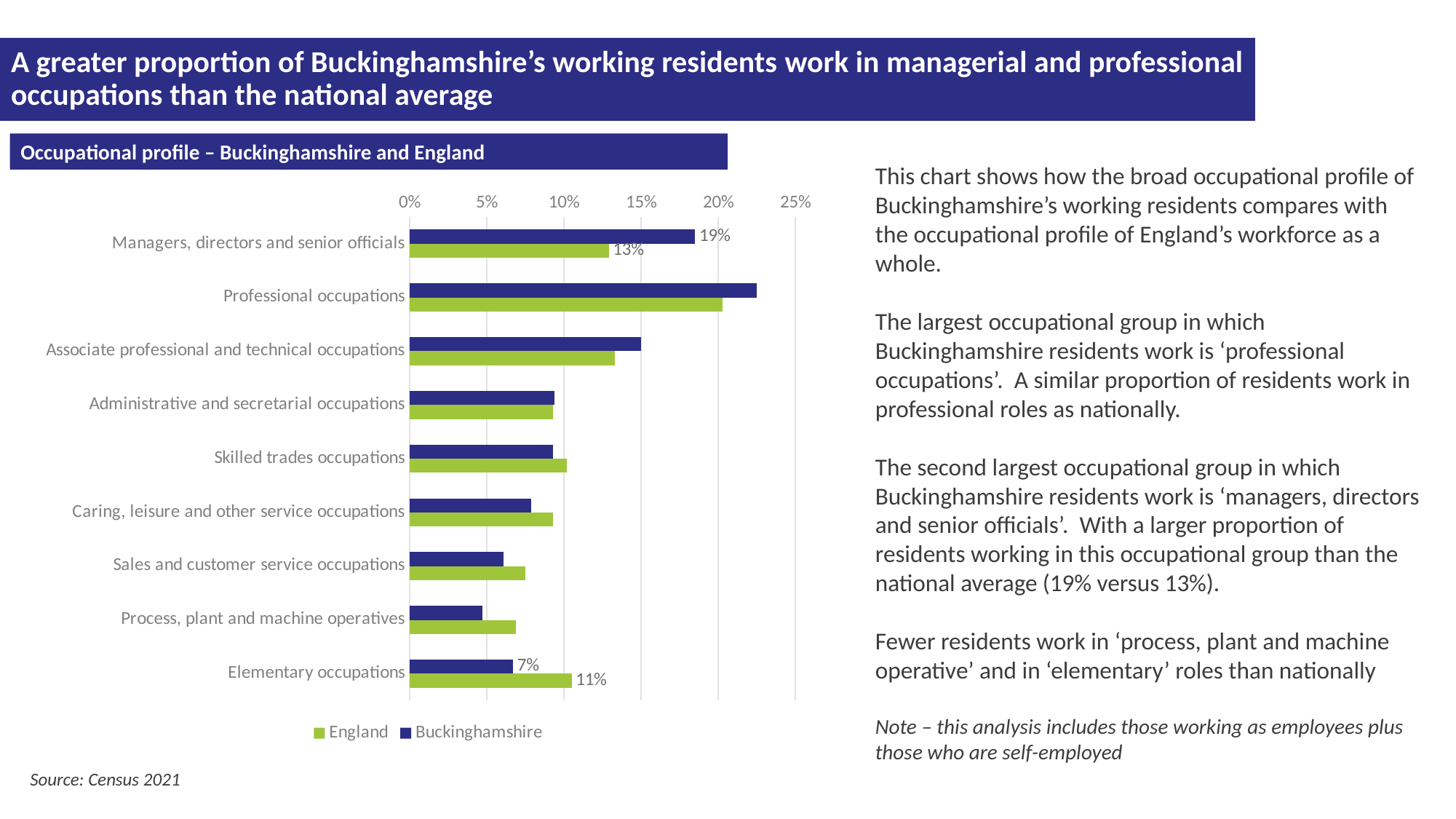
How many series does the chart legend list? 2 How many occupational categories are shown on the chart? 9 What is the value for England in 'Elementary occupations'? 11% Which occupational category has the highest value for Buckinghamshire? Professional occupations Is the Buckinghamshire value for 'Professional occupations' greater or less than 20%? greater What is the value for Buckinghamshire in 'Managers, directors and senior officials'? 19% Which occupational category has the lowest value for Buckinghamshire? Process, plant and machine operatives What is the title of the chart? Occupational profile – Buckinghamshire and England What is the difference between the Buckinghamshire and England values for 'Managers, directors and senior officials'? 6 percentage points What is the value for England in 'Managers, directors and senior officials'? 13% What type of chart is shown on the slide? Bar chart What is the difference between the England and Buckinghamshire values for 'Elementary occupations'? 4 percentage points